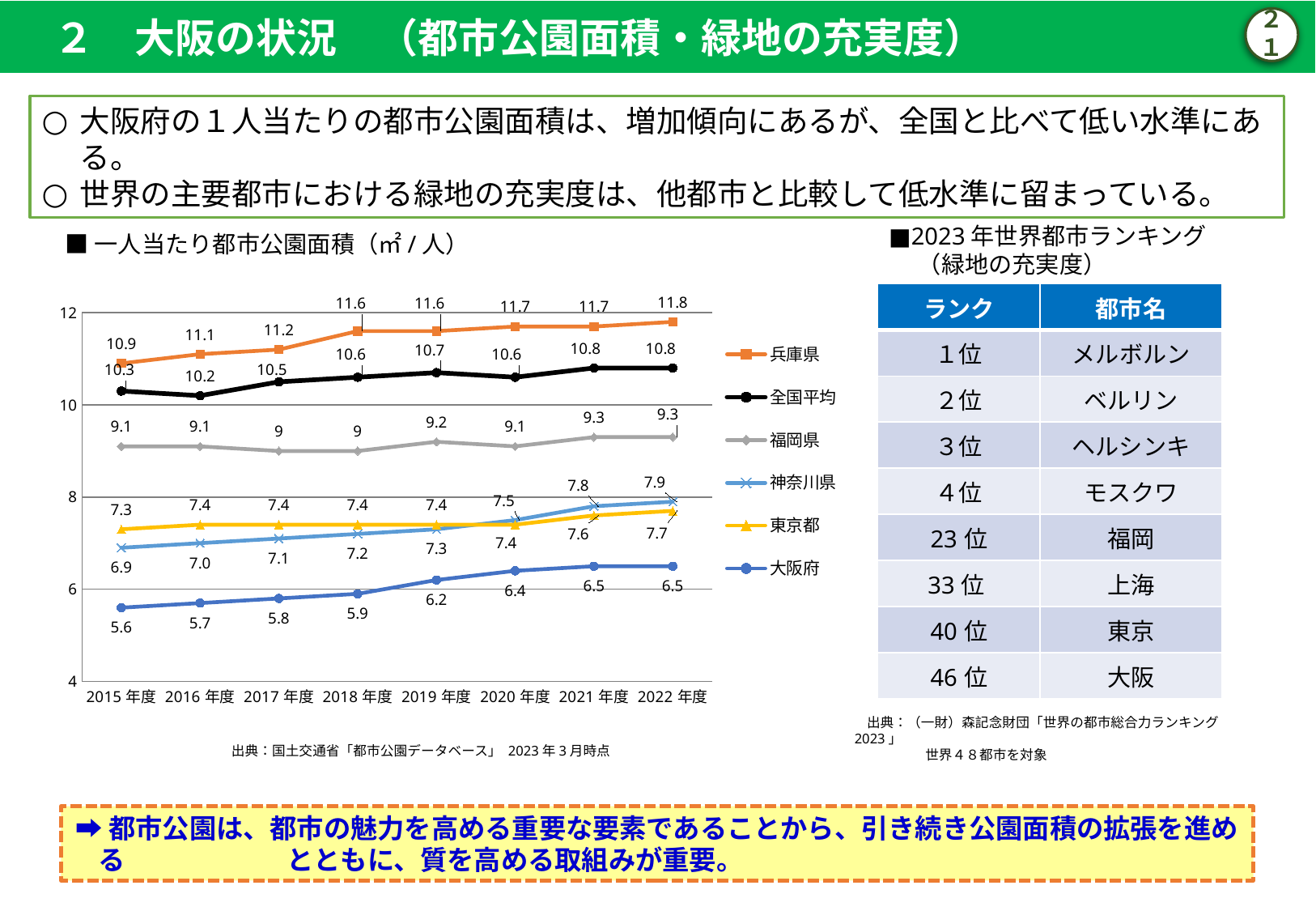
Which series has the highest value in 2022年度? 兵庫県 Is the value for 福岡県 in 2020年度 greater or less than 10? less What kind of chart is shown? line chart What is the value for 全国平均 in 2019年度? 10.7 Does the value for 大阪府 rise or fall from 2015年度 to 2022年度? rise What is the difference between 全国平均 and 大阪府 in 2022年度? 4.3 What is the value for 大阪府 in 2015年度? 5.6 Which is larger in 2022年度, 神奈川県 or 東京都? 神奈川県 How many series does the legend list? 6 Which series has the lowest value in 2018年度? 大阪府 How many fiscal years are plotted on the x axis? 8 What is the value for 兵庫県 in 2022年度? 11.8